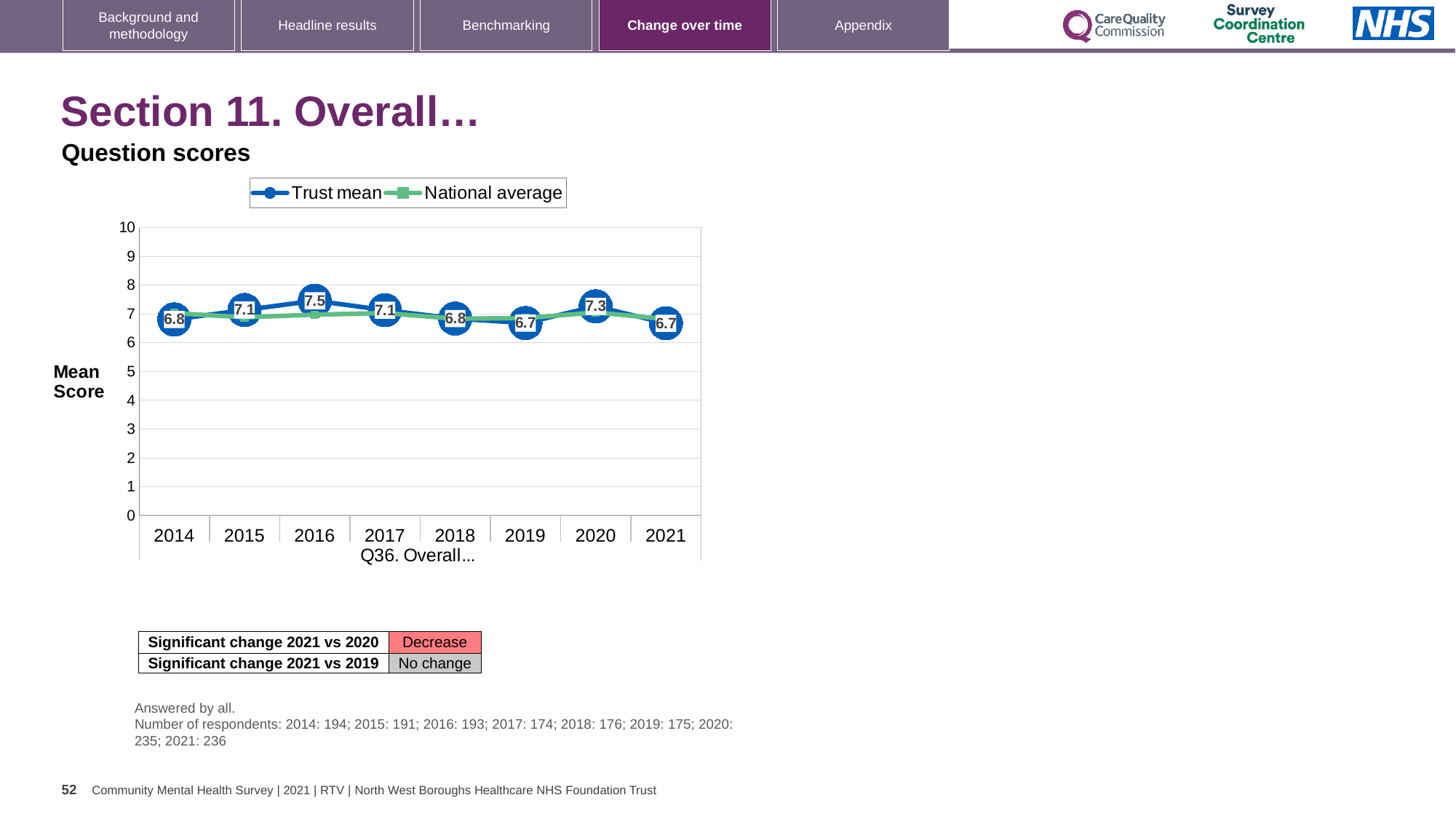
How many series does the legend list? 2 What kind of chart is shown? Line chart What is the Trust mean for 2016? 7.5 What is the difference between the Trust mean in 2016 and in 2021? 0.8 What is the Trust mean for 2014? 6.8 Is the National average for 2021 greater or less than 8? less Which year has the larger Trust mean, 2020 or 2021? 2020 In which year is the Trust mean highest? 2016 How many years are shown on the x axis? 8 What is the lowest Trust mean value shown on the chart? 6.7 Does the Trust mean rise or fall from 2020 to 2021? Fall What is the Trust mean for 2021? 6.7